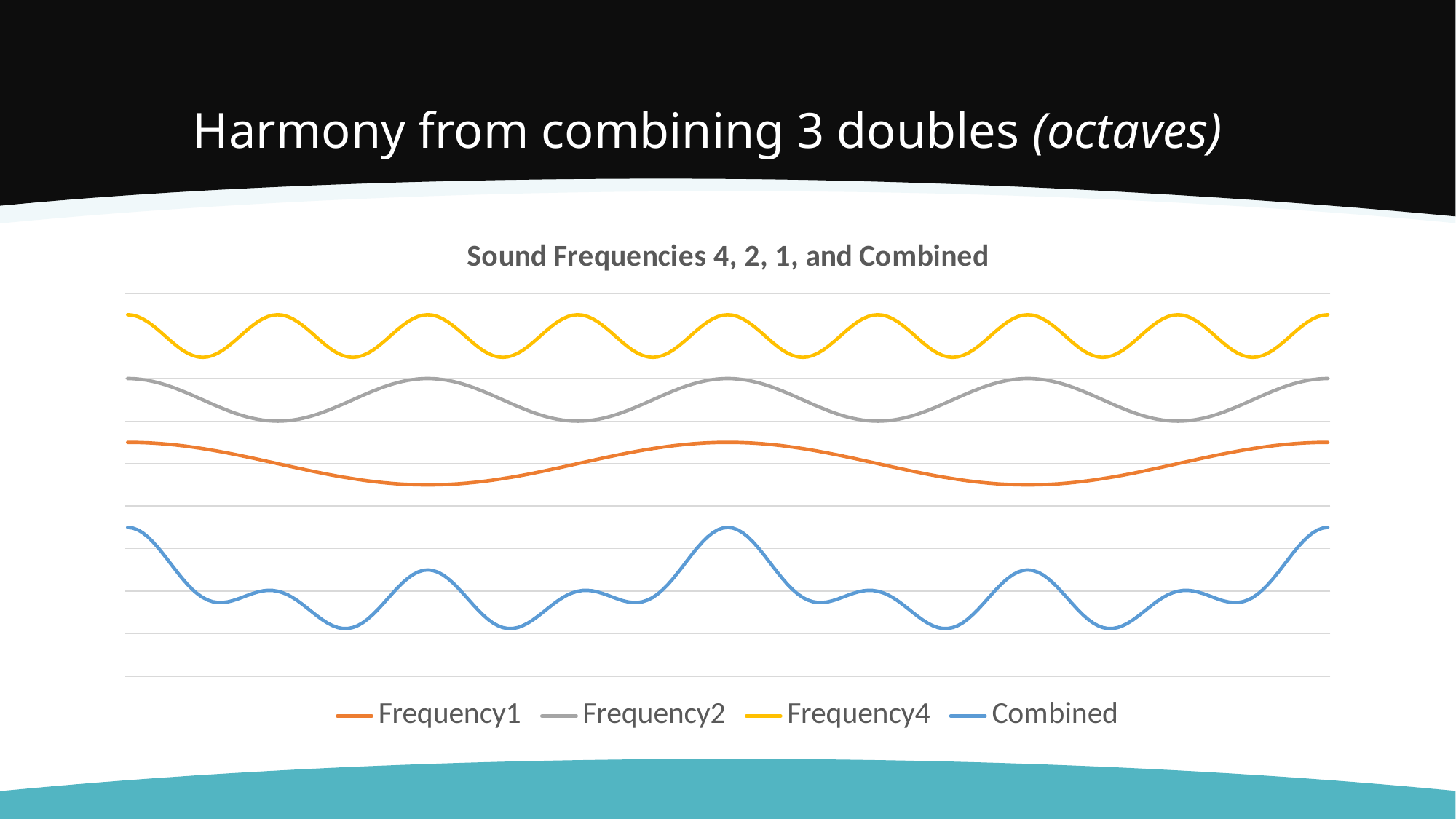
How many series does the chart legend list? 4 How many complete cycles does the Frequency2 line show across the chart? 4 Does the Frequency2 line oscillate faster or slower than the Frequency1 line? Faster Which series completes the most oscillations across the chart? Frequency4 Which series is drawn in yellow? Frequency4 How many complete cycles does the Frequency1 line show across the chart? 2 What is the title of the chart? Sound Frequencies 4, 2, 1, and Combined What kind of chart is shown on the slide? Line chart Which series has the largest peak-to-trough swing on the chart? Combined How many complete cycles does the Frequency4 line show across the chart? 8